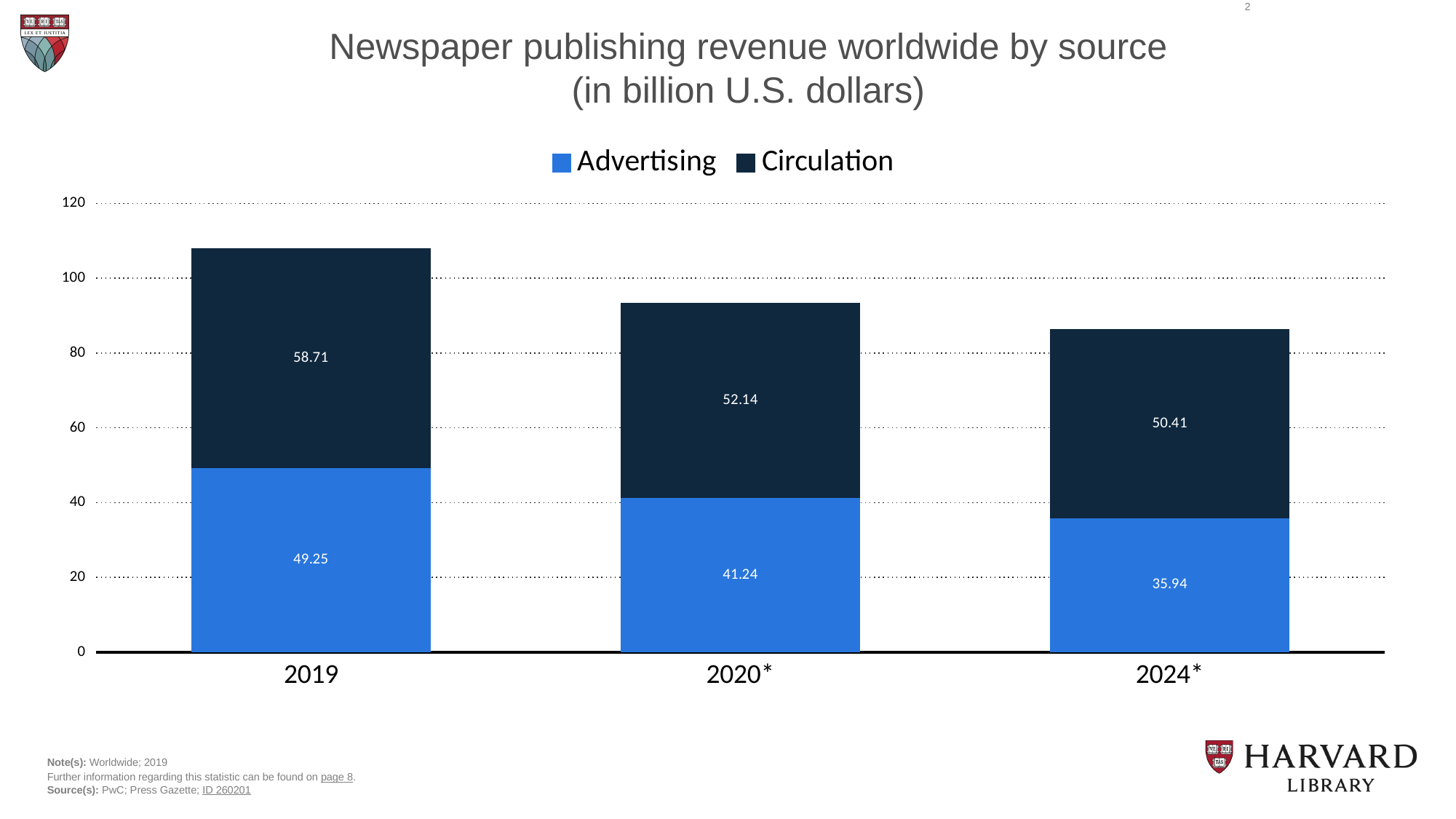
Which year has the highest Advertising revenue? 2019 What is the total revenue for 2019 (Advertising plus Circulation)? 107.96 What kind of chart is shown? Stacked bar chart How many years are shown on the x axis? 3 Which is larger in 2020*: Advertising or Circulation revenue? Circulation Which year has the lowest Circulation revenue? 2024* What is the Circulation revenue for 2024*? 50.41 What is the difference between Circulation revenue in 2019 and 2024*? 8.30 What is the Circulation revenue for 2020*? 52.14 Does Advertising revenue rise or fall from 2019 to 2024*? Fall How many series does the legend list? 2 What is the Advertising revenue for 2019? 49.25